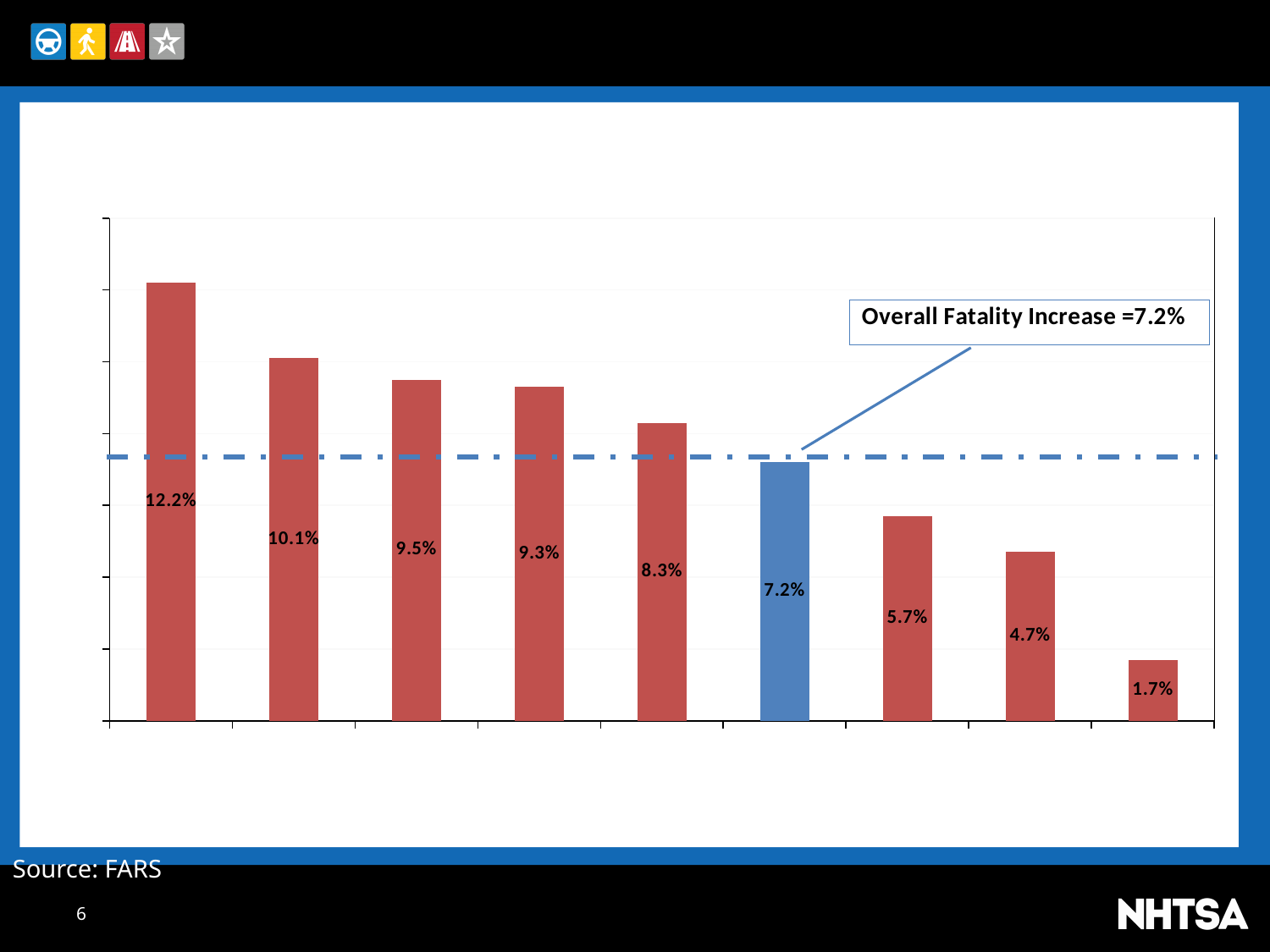
How many bars are plotted in the chart? 9 Which is larger, the third bar from the left (9.5%) or the fourth bar from the left (9.3%)? the third bar (9.5%) What kind of chart is shown on the slide? bar chart What is the value of the shortest bar in the chart? 1.7% What is the value of the second bar from the right? 4.7% What is the value of the fifth bar from the left? 8.3% What is the value of the second bar from the left? 10.1% What is the value shown on the blue bar? 7.2% What is the value of the tallest bar in the chart? 12.2% What does the text box annotation on the chart say? Overall Fatality Increase =7.2% Do the bar values rise or fall from left to right across the chart? fall What is the difference between the tallest bar (12.2%) and the shortest bar (1.7%)? 10.5%